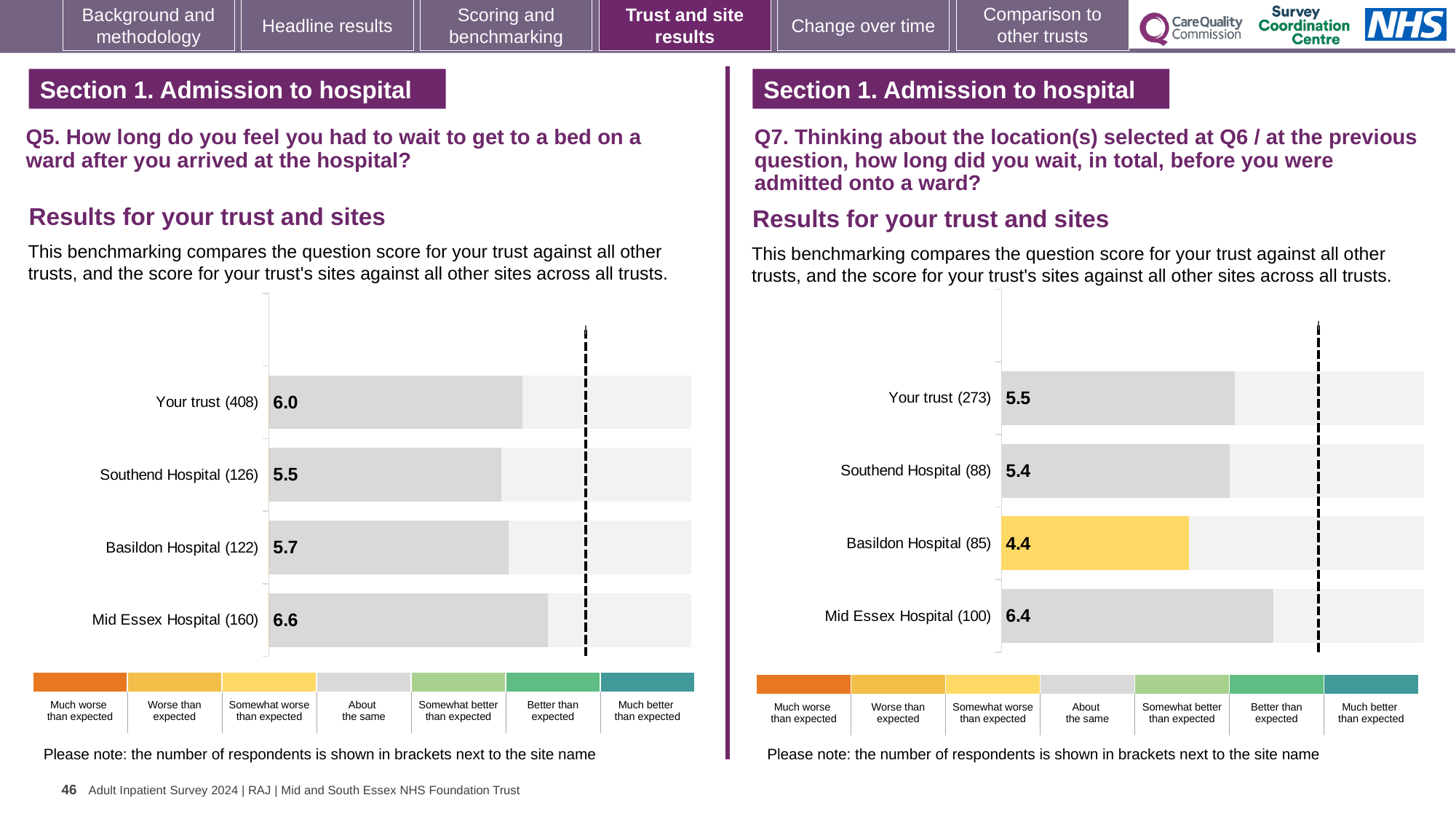
In the Q7 chart on the right, what is the score for Basildon Hospital? 4.4 In the Q5 chart on the left, what is the score for Mid Essex Hospital? 6.6 In the Q5 chart on the left, what is the difference between the scores for Mid Essex Hospital and Basildon Hospital? 0.9 In the Q7 chart on the right, what is the difference between the scores for Mid Essex Hospital and Basildon Hospital? 2.0 What type of chart is used for the Q5 results on the left? Bar chart In the Q7 chart on the right, which site has the highest score? Mid Essex Hospital In the Q7 chart on the right, which benchmark category does the colour of the Basildon Hospital bar indicate? Somewhat worse than expected In the Q7 chart on the right, which is larger, the score for Your trust or the score for Southend Hospital? Your trust In the Q5 chart on the left, how many respondents are shown for Basildon Hospital? 122 In the Q5 chart on the left, what is the score for Your trust? 6.0 How many bars are plotted in the Q7 chart on the right? 4 In the Q5 chart on the left, which site has the lowest score? Southend Hospital